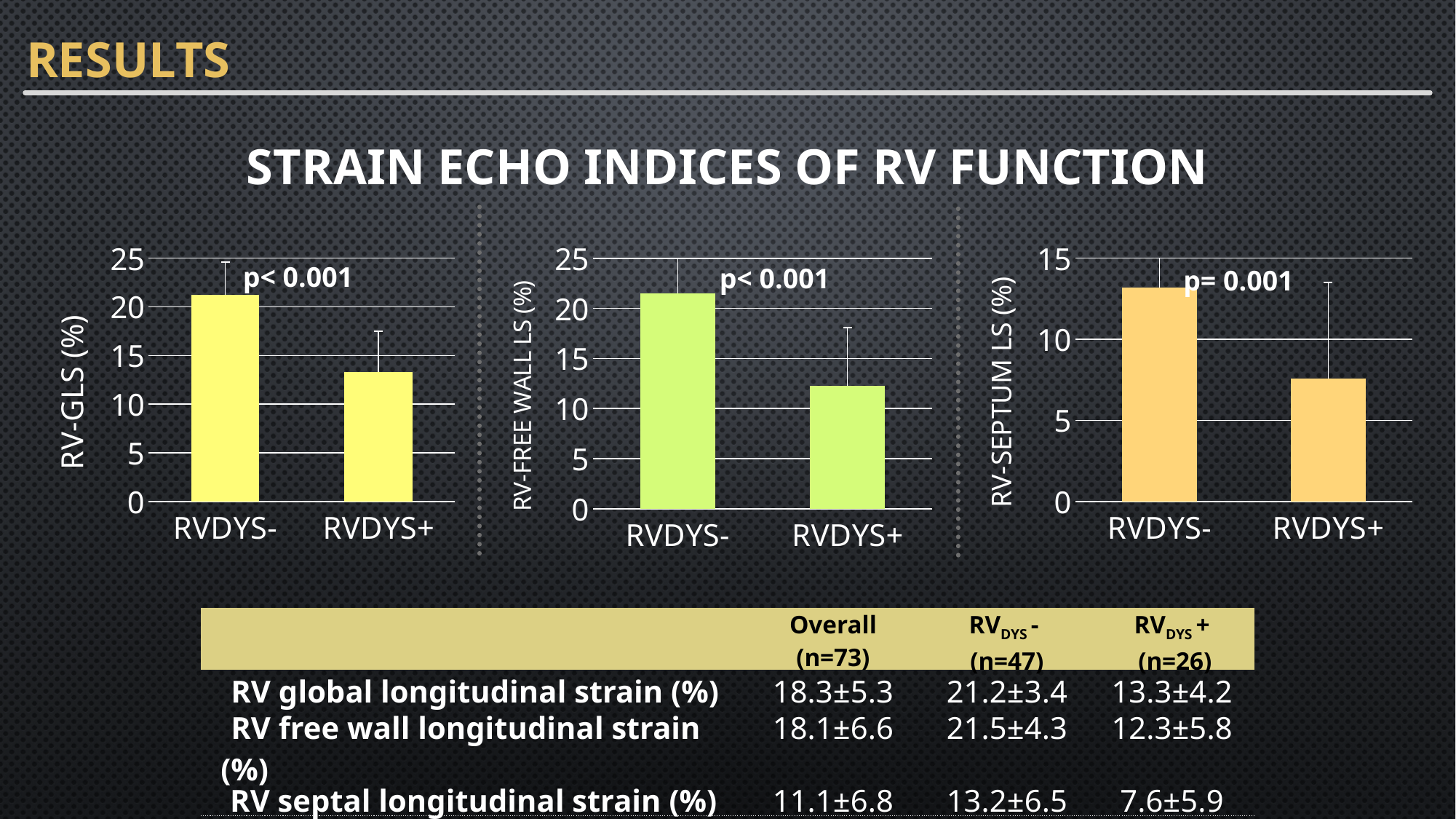
In the RV-GLS (%) chart, is the value for RVDYS+ greater or less than 15? less In the RV-FREE WALL LS (%) chart, is the value for RVDYS+ greater or less than 10? greater In the RV-GLS (%) chart, which category has the higher bar, RVDYS- or RVDYS+? RVDYS- In the RV-SEPTUM LS (%) chart, which category has the lowest bar? RVDYS+ What kind of chart is the RV-GLS (%) chart on the left? bar chart In the RV-SEPTUM LS (%) chart, is the value for RVDYS+ greater or less than 10? less What p-value is annotated on the RV-SEPTUM LS (%) chart? p= 0.001 What is the y-axis label of the middle chart? RV-FREE WALL LS (%) How many categories are shown on the x axis of the RV-FREE WALL LS (%) chart? 2